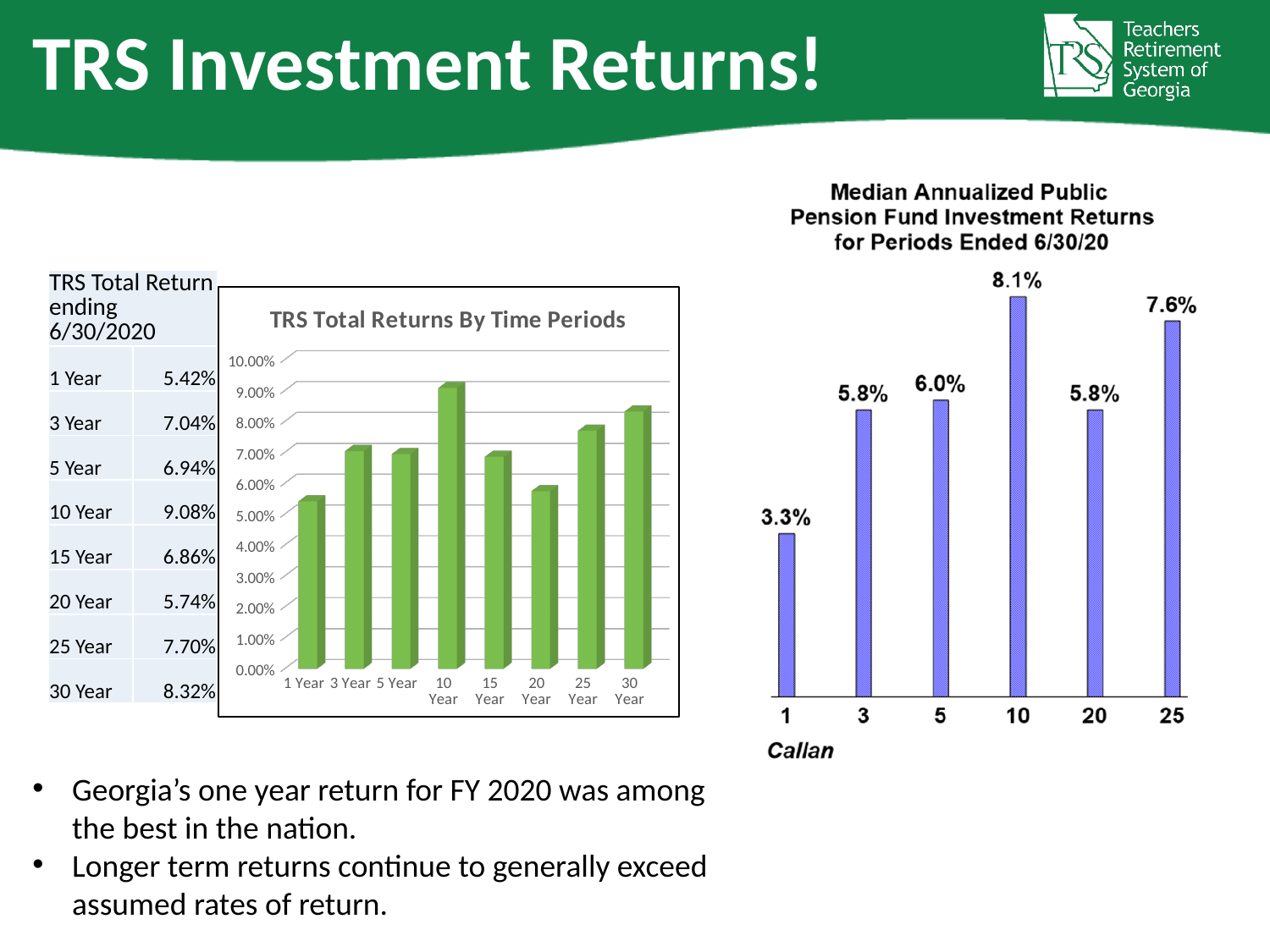
In the 'TRS Total Returns By Time Periods' chart, which time period has the highest return? 10 Year In the 'Median Annualized Public Pension Fund Investment Returns' chart, what is the value for the 1-year period? 3.3% What kind of chart is 'TRS Total Returns By Time Periods'? Bar chart In the 'TRS Total Returns By Time Periods' chart, which is larger, the 25 Year return or the 30 Year return? 30 Year In the 'TRS Total Returns By Time Periods' chart, which time period has the lowest return? 1 Year In the 'TRS Total Returns By Time Periods' chart, is the value for 10 Year greater or less than 9.00%? greater In the 'Median Annualized Public Pension Fund Investment Returns' chart, what is the value for the 10-year period? 8.1% In the 'Median Annualized Public Pension Fund Investment Returns' chart, how many periods are plotted? 6 In the 'Median Annualized Public Pension Fund Investment Returns' chart, which period has the lowest value? 1 In the 'TRS Total Returns By Time Periods' chart, how many time periods are plotted? 8 In the 'TRS Total Returns By Time Periods' chart, is the value for 20 Year greater or less than 6.00%? less In the 'Median Annualized Public Pension Fund Investment Returns' chart, what is the difference between the 25-year value and the 20-year value? 1.8%